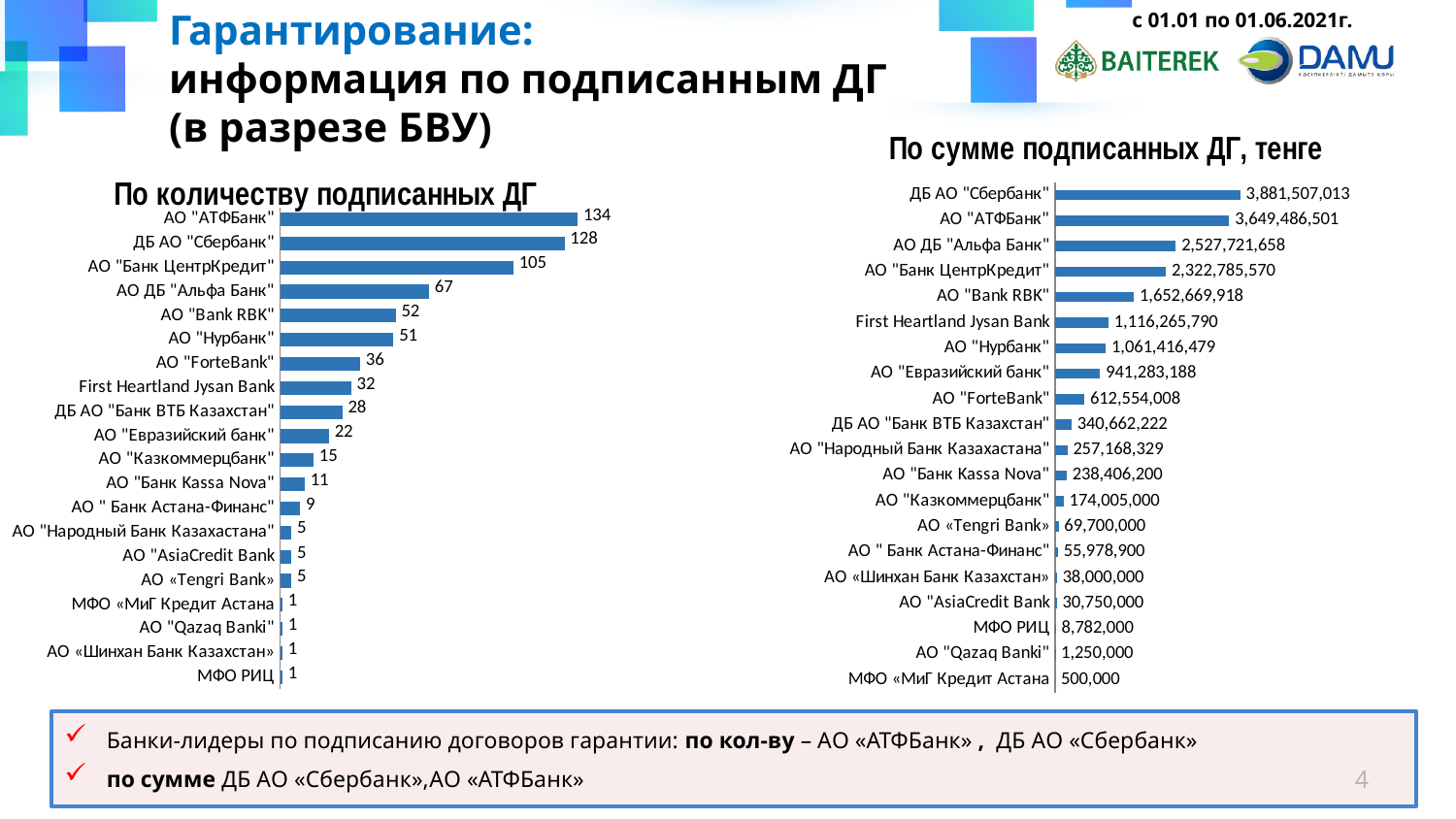
In the chart "По сумме подписанных ДГ, тенге", what is the difference between ДБ АО "Сбербанк" and АО "АТФБанк"? 232,020,512 In the chart "По количеству подписанных ДГ", what is the value for АО "АТФБанк"? 134 In the chart "По сумме подписанных ДГ, тенге", which is larger: АО ДБ "Альфа Банк" or АО "Банк ЦентрКредит"? АО ДБ "Альфа Банк" In the chart "По сумме подписанных ДГ, тенге", which bank has the lowest value? МФО «МиГ Кредит Астана In the chart "По сумме подписанных ДГ, тенге", what is the value for АО "Евразийский банк"? 941,283,188 In the chart "По количеству подписанных ДГ", how many banks are listed? 20 In the chart "По количеству подписанных ДГ", what is the difference between АО "АТФБанк" and ДБ АО "Сбербанк"? 6 In the chart "По количеству подписанных ДГ", what is the value for АО "Bank RBK"? 52 What type of chart is "По сумме подписанных ДГ, тенге"? Bar chart In the chart "По количеству подписанных ДГ", which is larger: АО "ForteBank" or First Heartland Jysan Bank? АО "ForteBank" In the chart "По количеству подписанных ДГ", which bank has the highest value? АО "АТФБанк" In the chart "По сумме подписанных ДГ, тенге", what is the value for ДБ АО "Сбербанк"? 3,881,507,013